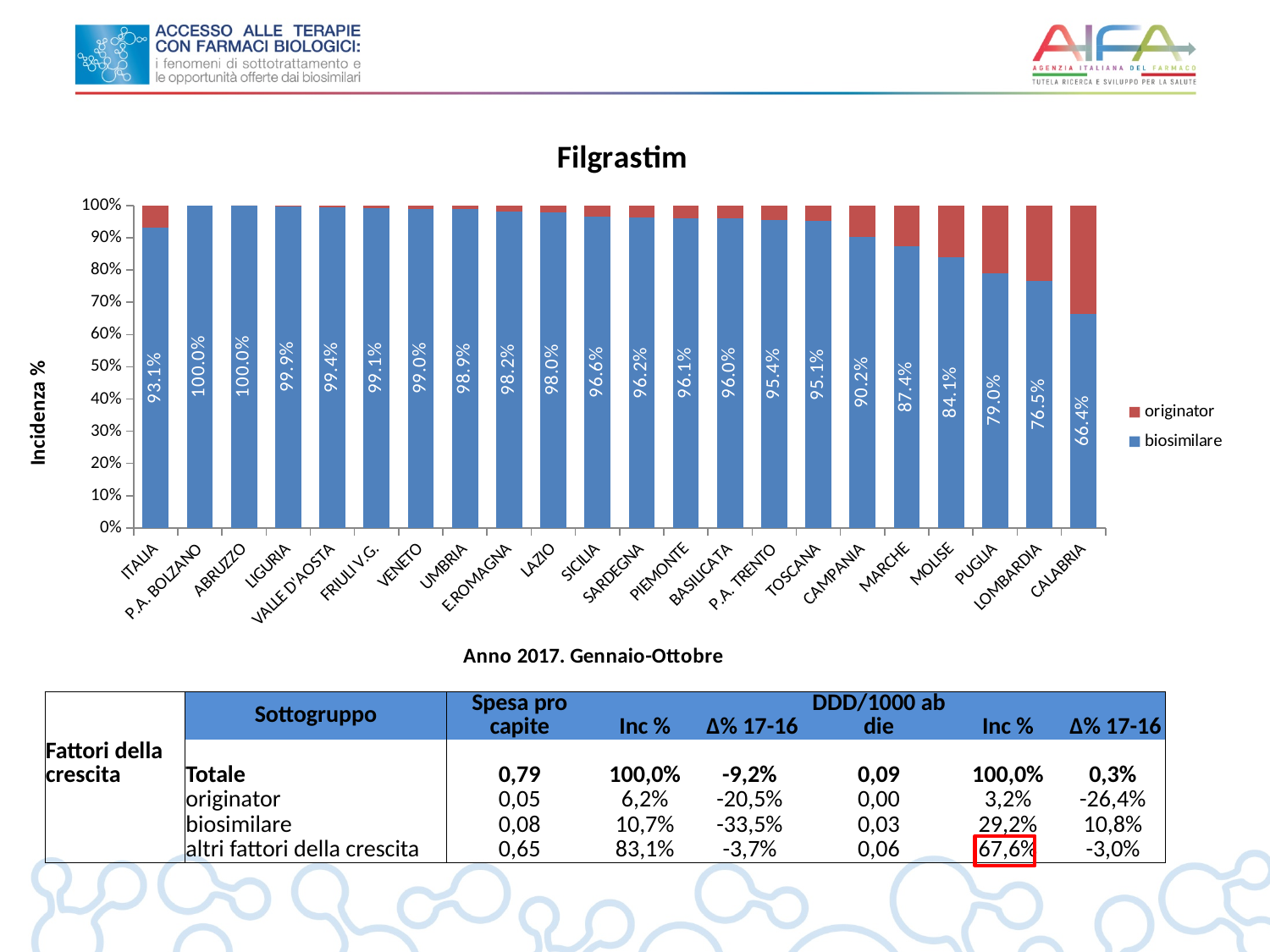
What is the biosimilare value for LOMBARDIA in the Filgrastim chart? 76.5% What is the biosimilare value for CALABRIA in the Filgrastim chart? 66.4% Is the biosimilare value for CALABRIA in the Filgrastim chart greater or less than 70%? less Which has a larger biosimilare value in the Filgrastim chart, MARCHE or MOLISE? MARCHE What is the biosimilare value for ITALIA in the Filgrastim chart? 93.1% Do the biosimilare values in the Filgrastim chart generally rise or fall from left to right after ITALIA? fall Which region has the lowest biosimilare value in the Filgrastim chart? CALABRIA What kind of chart is the Filgrastim chart? Stacked bar chart How many regions are shown on the x axis of the Filgrastim chart? 22 How many series does the legend of the Filgrastim chart list? 2 What is the biosimilare value for CAMPANIA in the Filgrastim chart? 90.2% What is the difference between the biosimilare values for MOLISE and PUGLIA in the Filgrastim chart? 5.1 percentage points